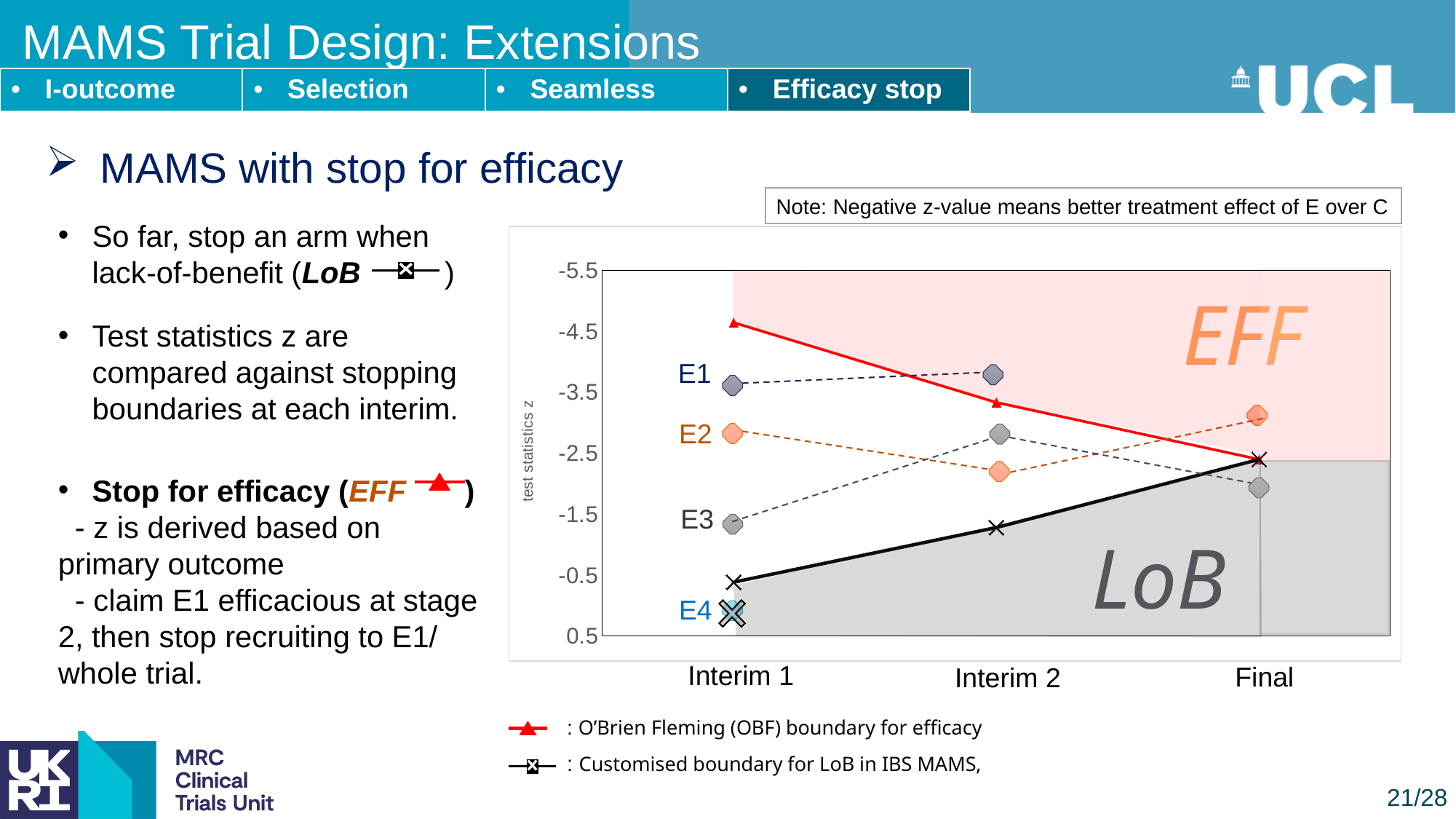
What is the label of the y axis of the chart? test statistics z Is the z value for E1 at Interim 1 greater or less than -2.5? less How many time points are shown on the x axis of the chart? 3 How many boundary entries does the legend below the chart list? 2 How many experimental arms (E1, E2, ...) are labelled on the chart? 4 According to the legend, what does the red line with triangle markers represent? O'Brien Fleming (OBF) boundary for efficacy Which arm has the most negative z value at Interim 2? E1 Is the z value for E4 at Interim 1 greater or less than -0.5? greater Which arm has the more negative z value at Interim 1, E1 or E3? E1 What kind of chart is shown on the slide? line chart Is the z value for E3 at Interim 1 greater or less than -2.5? greater